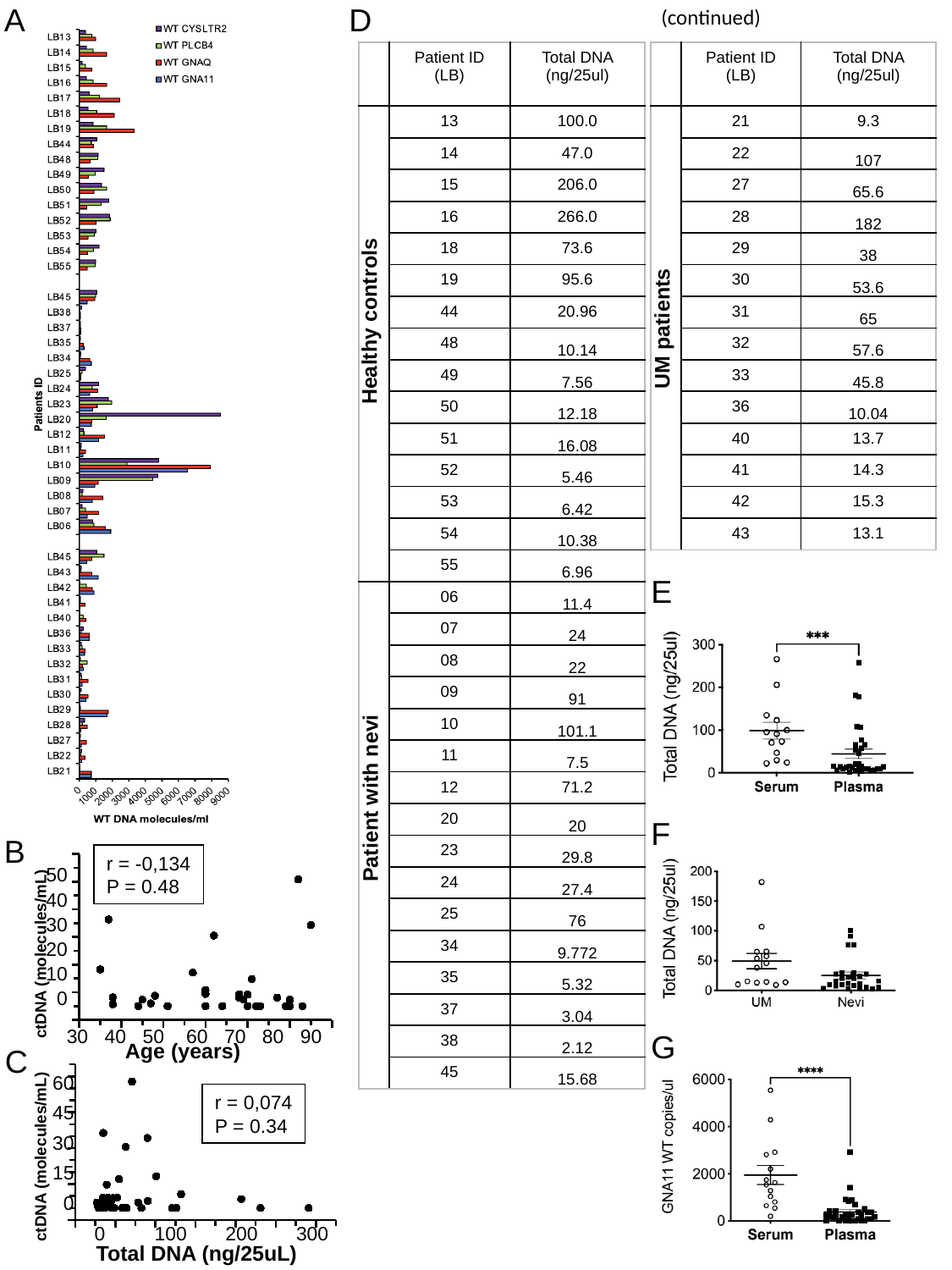
In chart G, how many categories are shown on the x axis? 2 In chart A, what is the title of the x axis? WT DNA molecules/ml What kind of chart is chart A? bar chart What kind of chart is chart B? scatter plot What kind of chart is chart C? scatter plot In chart E, is the highest Plasma point greater or less than 200? greater In chart E, how many categories are shown on the x axis? 2 In chart F, is the highest UM point greater or less than 150? greater In chart A, is the WT GNA11 value for LB37 greater or less than 1000? less In chart B, what correlation coefficient r is shown in the text box? r = -0,134 In chart A, how many series does the legend list? 4